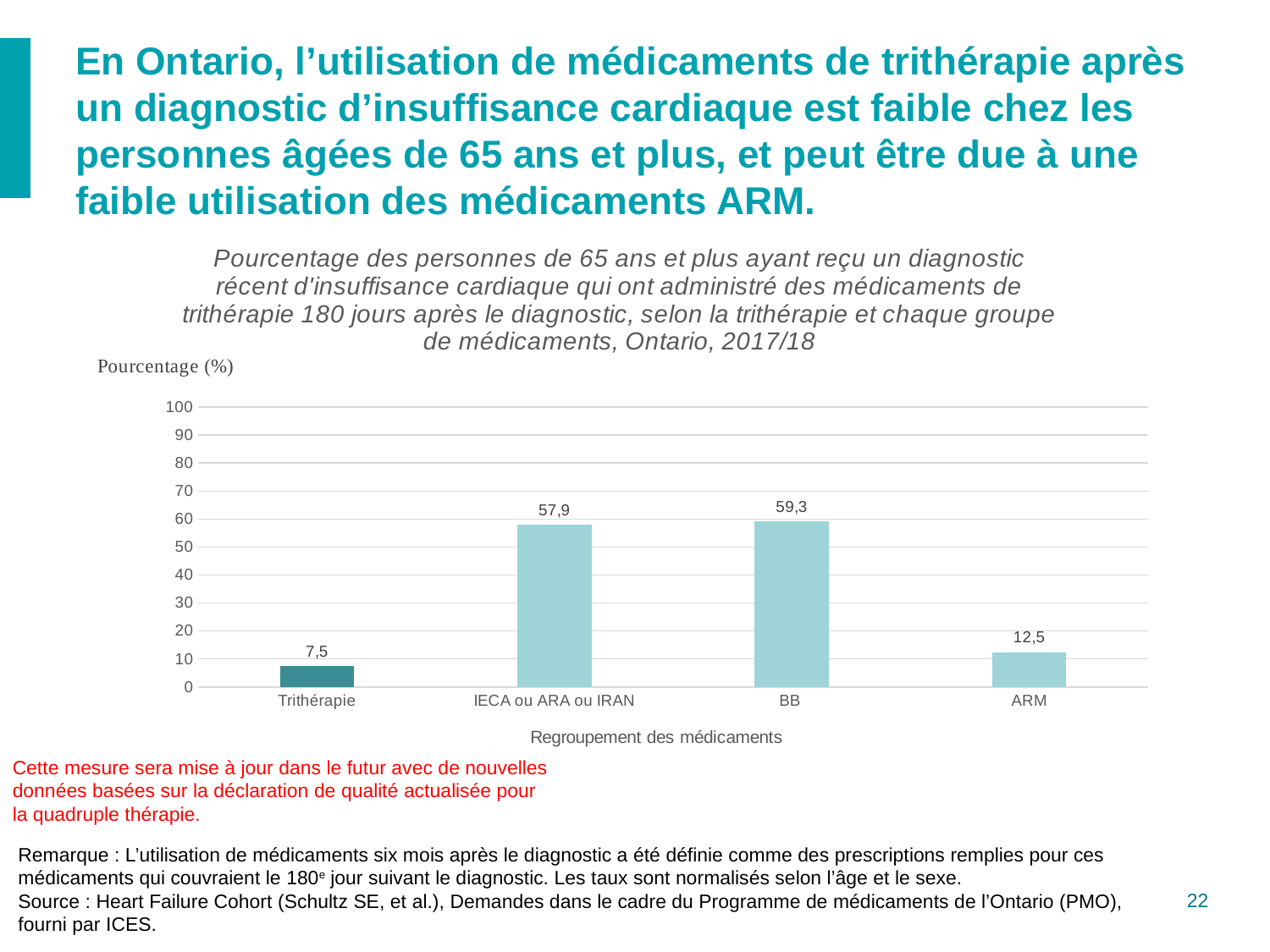
How many categories are shown on the x axis? 4 What is the value for IECA ou ARA ou IRAN? 57,9 What is the value for ARM? 12,5 What is the difference between the values for BB and IECA ou ARA ou IRAN? 1,4 Which category has the highest value? BB Which is larger, the value for ARM or the value for Trithérapie? ARM What kind of chart is shown on the slide? Bar chart What is the difference between the values for ARM and Trithérapie? 5,0 What is the value for BB? 59,3 What is the value for Trithérapie? 7,5 Which category has the lowest value? Trithérapie What is the label of the x axis? Regroupement des médicaments